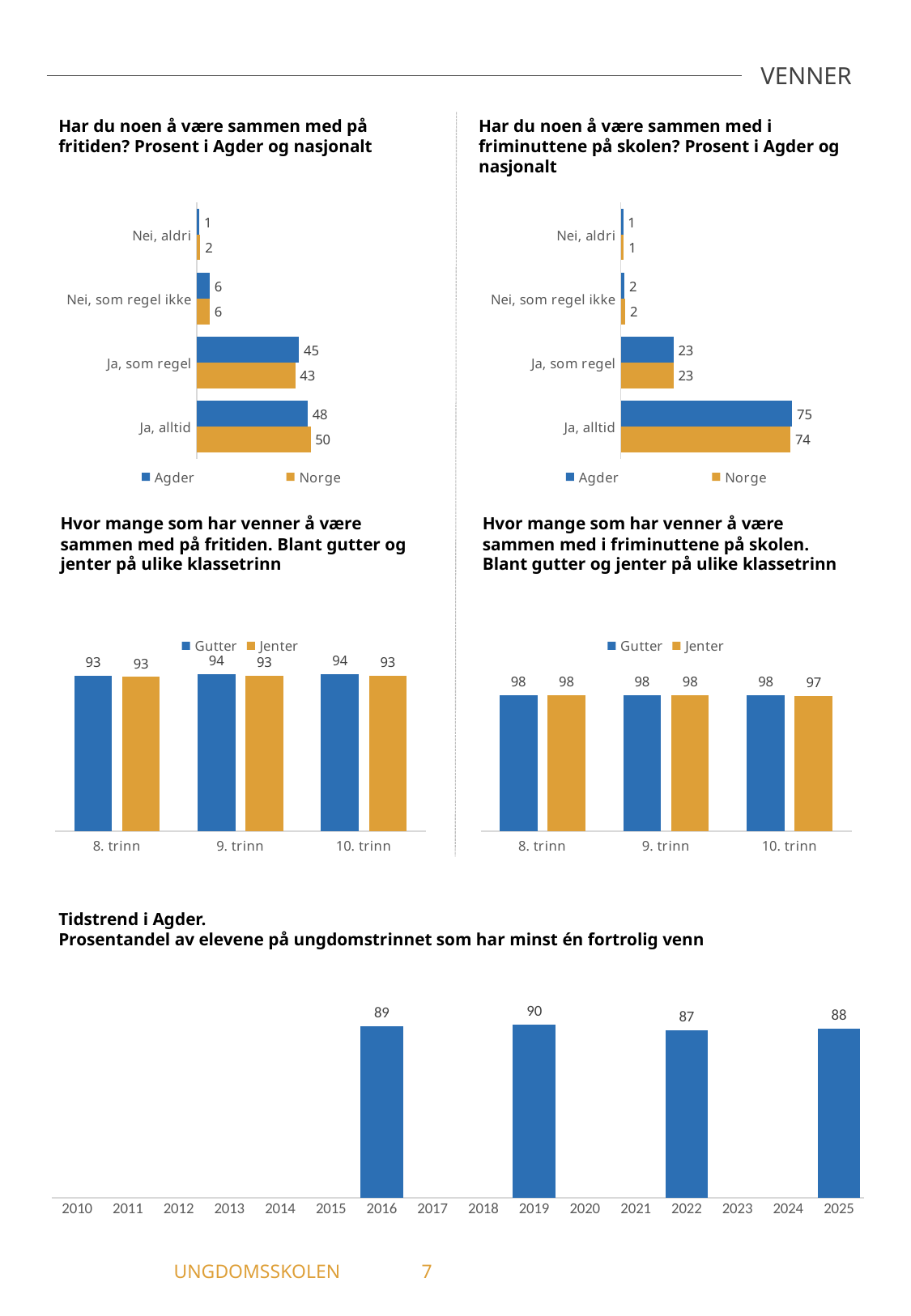
In the chart 'Har du noen å være sammen med på fritiden? Prosent i Agder og nasjonalt', what is the Agder value for 'Ja, alltid'? 48 In the chart 'Hvor mange som har venner å være sammen med på fritiden. Blant gutter og jenter på ulike klassetrinn', what is the value for Gutter in 9. trinn? 94 In the chart 'Hvor mange som har venner å være sammen med i friminuttene på skolen. Blant gutter og jenter på ulike klassetrinn', what is the value for Jenter in 10. trinn? 97 What kind of chart is the 'Tidstrend i Agder' chart at the bottom of the slide? Bar chart In the chart 'Tidstrend i Agder', which year has the lowest value? 2022 In the chart 'Tidstrend i Agder', what is the value for 2019? 90 In the chart 'Har du noen å være sammen med i friminuttene på skolen? Prosent i Agder og nasjonalt', what is the Norge value for 'Ja, alltid'? 74 In the chart 'Har du noen å være sammen med på fritiden? Prosent i Agder og nasjonalt', what is the difference between the Norge and Agder values for 'Ja, alltid'? 2 In the chart 'Har du noen å være sammen med i friminuttene på skolen? Prosent i Agder og nasjonalt', how many series does the legend list? 2 In the chart 'Har du noen å være sammen med på fritiden? Prosent i Agder og nasjonalt', which series has the larger value for 'Ja, som regel', Agder or Norge? Agder In the chart 'Har du noen å være sammen med i friminuttene på skolen? Prosent i Agder og nasjonalt', which category has the highest Agder value? Ja, alltid In the chart 'Hvor mange som har venner å være sammen med på fritiden. Blant gutter og jenter på ulike klassetrinn', how many class levels are shown on the x axis? 3